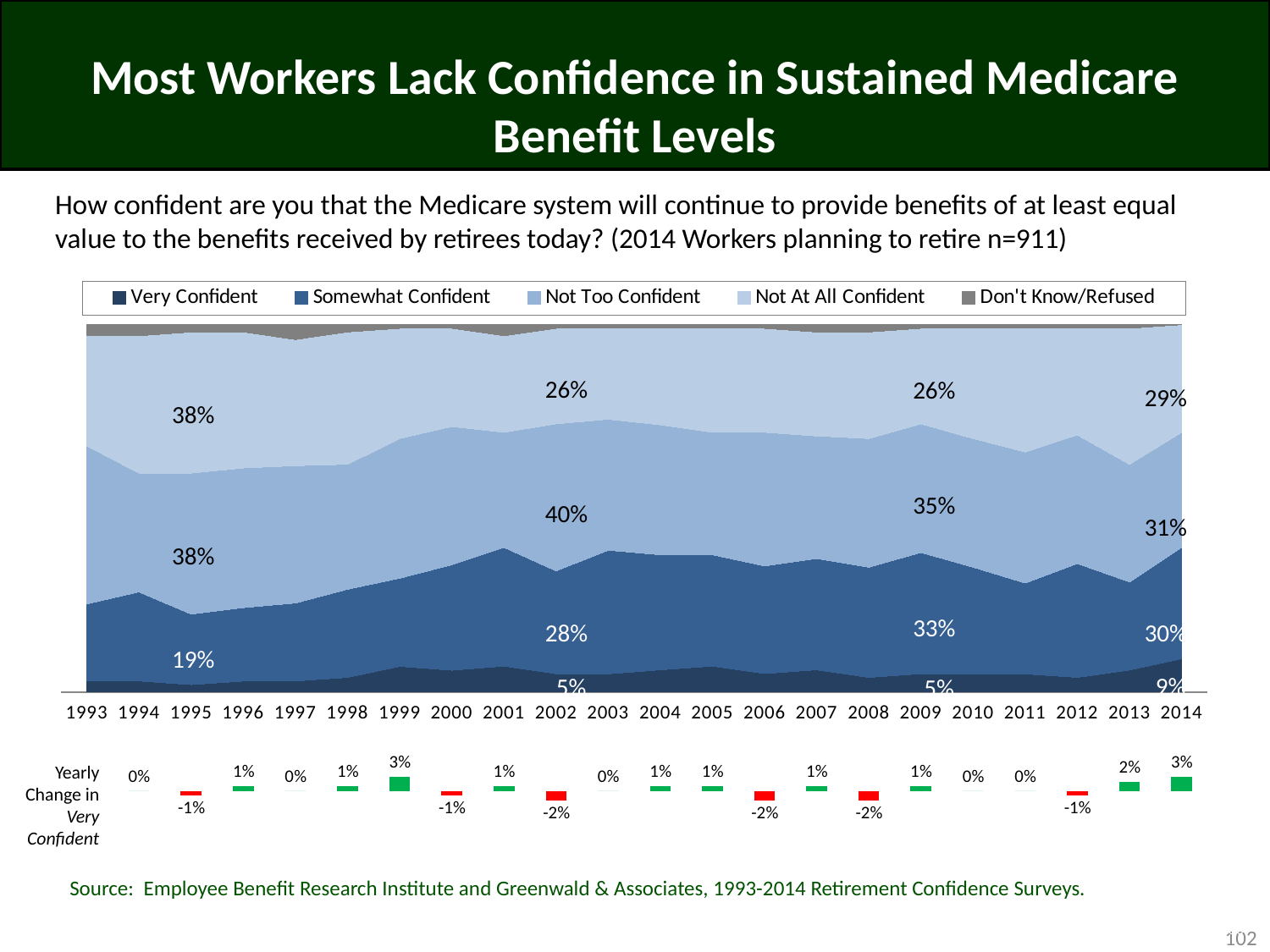
What kind of chart is the main chart on the slide? stacked area chart In the main chart, what is the difference between the Not At All Confident value in 2014 and in 2009? 3% In the Yearly Change in Very Confident chart at the bottom, what is the value for 1999? 3% In the main chart, what is the Not Too Confident value for 2002? 40% In the main chart, what is the Very Confident value for 2002? 5% In the Yearly Change in Very Confident chart at the bottom, what is the value for 2008? -2% How many series does the legend of the main chart list? 5 In the main chart, what is the Somewhat Confident value for 2009? 33% How many years are shown along the x axis of the main chart? 22 In the main chart, what is the Not At All Confident value for 1995? 38% In the main chart, what is the Very Confident value for 2014? 9% In the main chart, which is larger: the Not Too Confident value in 2002 or in 2009? 2002